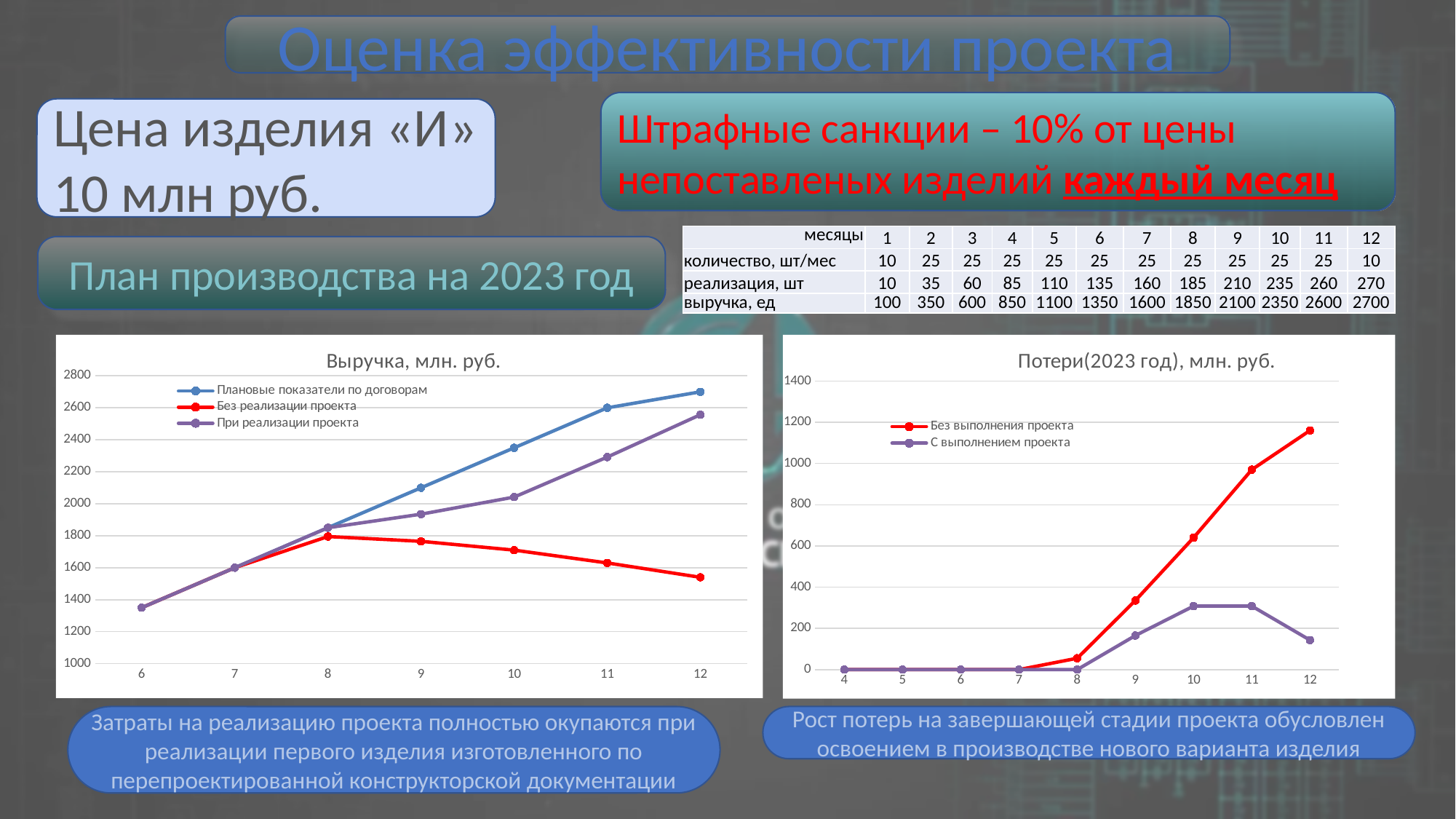
In the "Выручка, млн. руб." chart, is the value for "Без реализации проекта" at month 12 greater or less than 1600? less What type of chart is the chart titled "Выручка, млн. руб."? line chart How many series does the legend of the "Выручка, млн. руб." chart list? 3 In the "Потери(2023 год), млн. руб." chart, which series is larger at month 11: "Без выполнения проекта" or "С выполнением проекта"? Без выполнения проекта In the "Выручка, млн. руб." chart, how many months are shown on the x axis? 7 How many series does the legend of the "Потери(2023 год), млн. руб." chart list? 2 In the "Потери(2023 год), млн. руб." chart, how many months are shown on the x axis? 9 In the "Потери(2023 год), млн. руб." chart, is the value for "Без выполнения проекта" at month 12 greater or less than 1000? greater In the "Выручка, млн. руб." chart, is the value for "Плановые показатели по договорам" at month 12 greater or less than 2600? greater In the "Выручка, млн. руб." chart, which series has the highest value at month 12? Плановые показатели по договорам In the "Выручка, млн. руб." chart, does the "Без реализации проекта" line rise or fall from month 8 to month 12? fall